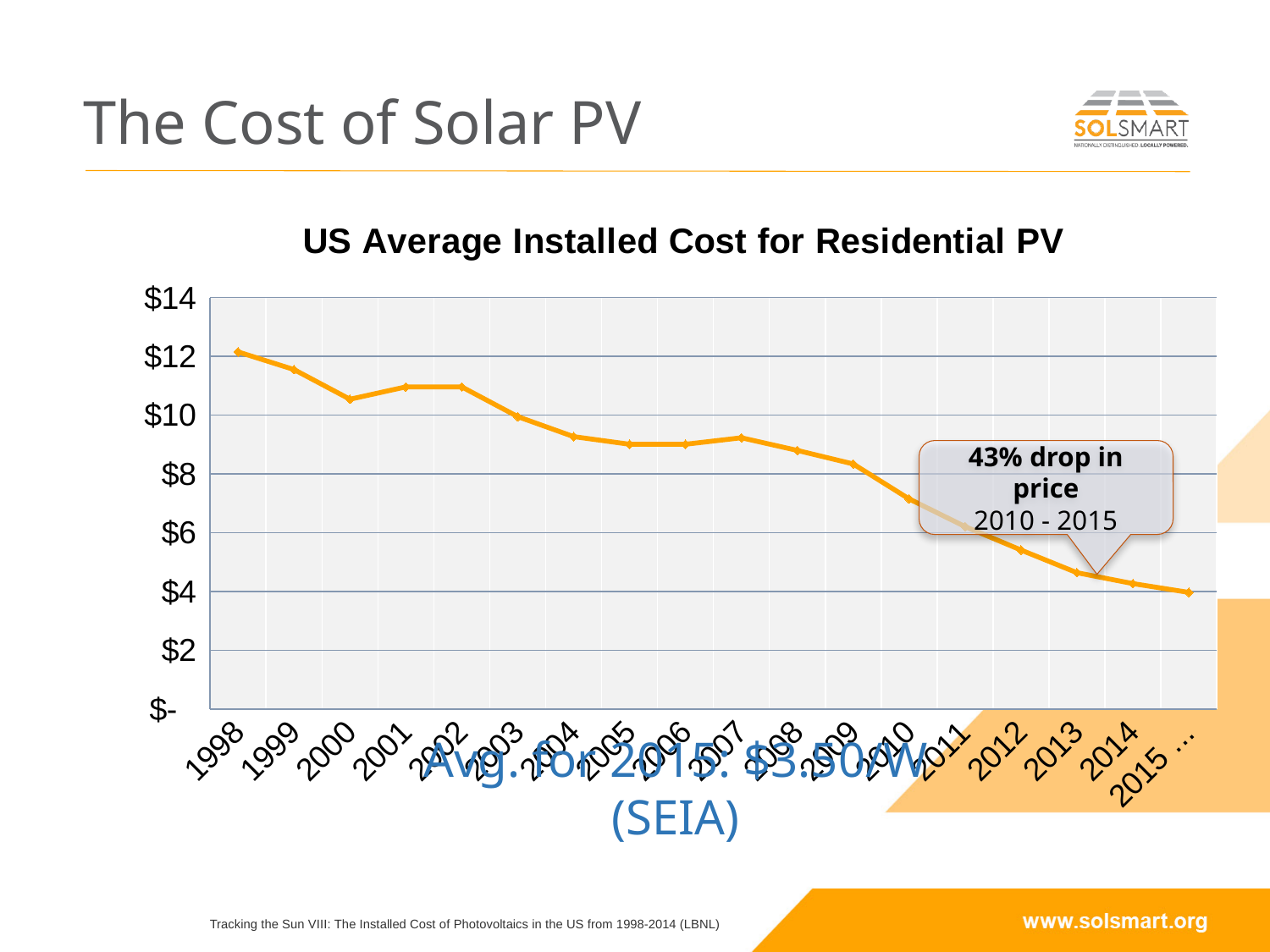
Which year has the larger value, 2009 or 2010? 2009 What kind of chart is shown on the slide? line chart Is the value for 2010 greater or less than $8? less Which year has the highest average installed cost in the chart? 1998 How many years are plotted along the x axis of the chart? 18 Is the value for 1998 greater or less than $10? greater Do the values in the chart generally rise or fall from 1998 to 2015? fall Which year has the lowest average installed cost in the chart? 2015 Is the value for 2012 greater or less than $6? less According to the callout on the chart, what percentage drop in price occurred from 2010 to 2015? 43% What is the title of the chart? US Average Installed Cost for Residential PV